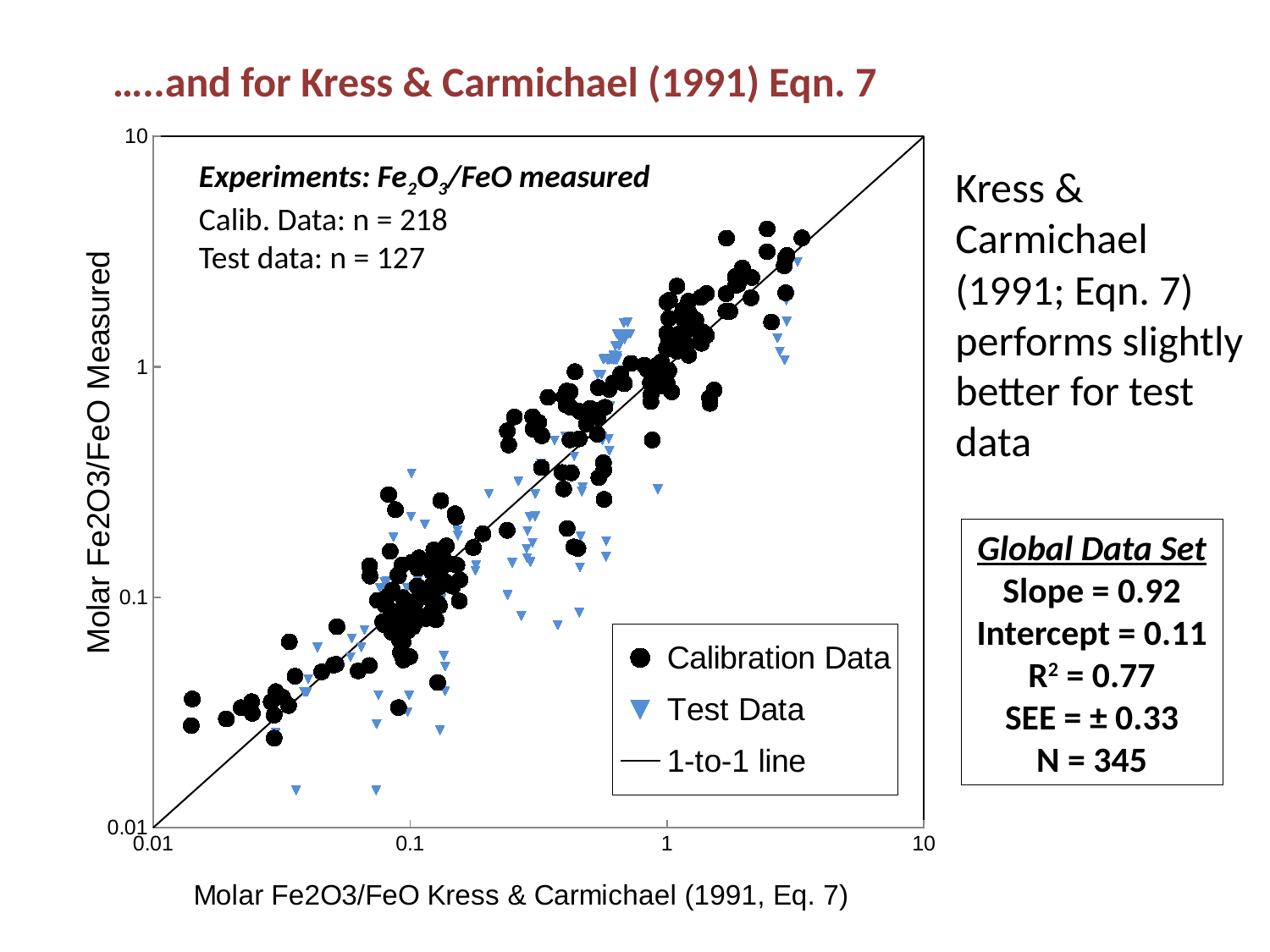
Do the measured Fe2O3/FeO values generally rise or fall as the Kress & Carmichael values increase along the x axis? rise What are the entries listed in the chart's legend? Calibration Data, Test Data, 1-to-1 line How many calibration data points does the chart state it contains? 218 What marker symbol is used for the Test Data series? blue downward triangle What is the label of the x axis? Molar Fe2O3/FeO Kress & Carmichael (1991, Eq. 7) How many data series does the chart's legend list? 3 What is the highest tick value shown on the y axis? 10 What is the difference between the number of calibration data points and test data points? 91 What is the lowest tick value shown on the x axis? 0.01 How many test data points does the chart state it contains? 127 What kind of chart is shown on the slide? scatter plot Which series has more points, Calibration Data or Test Data? Calibration Data